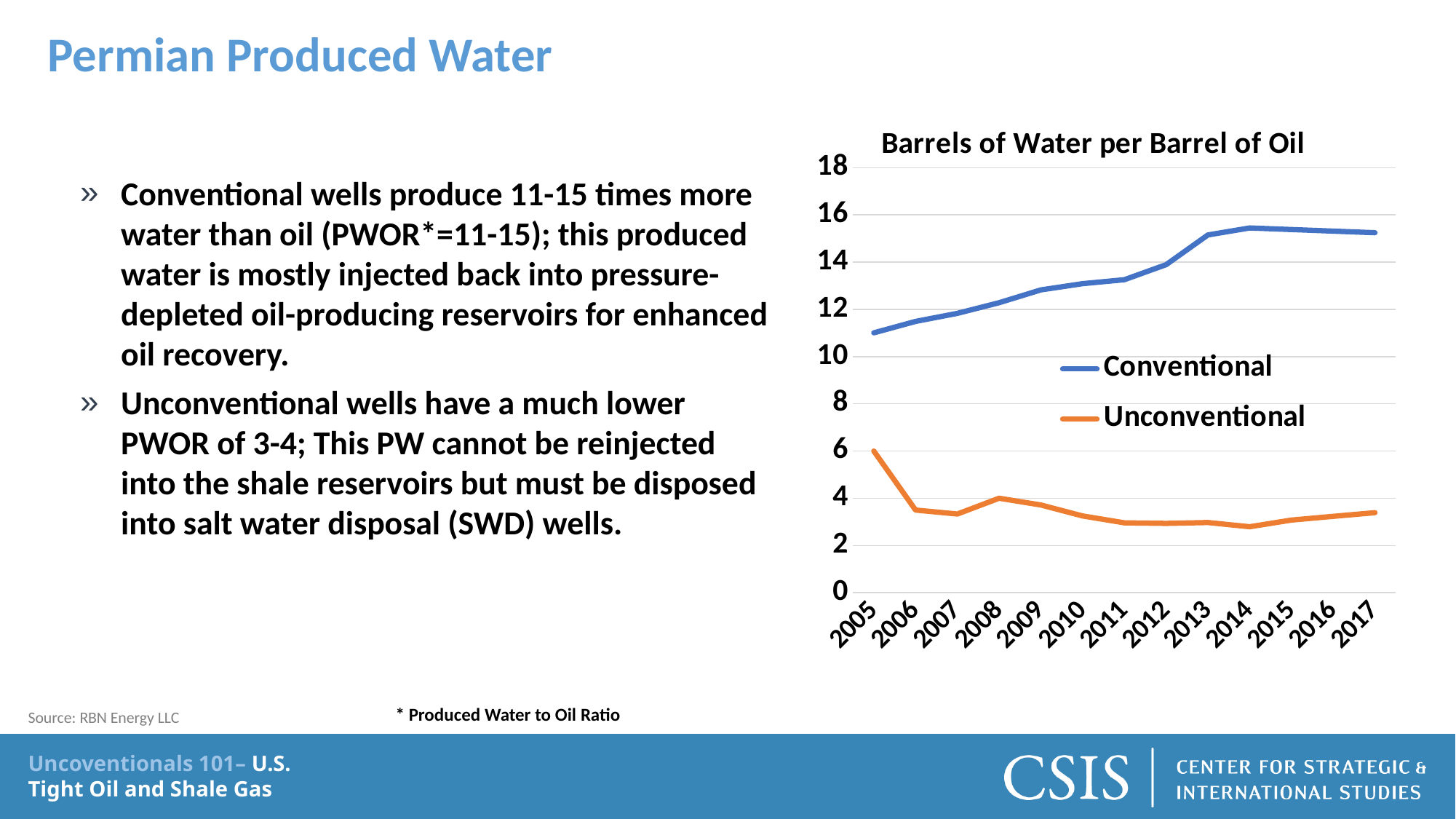
Is the Conventional value for 2017 greater or less than 14? greater Is the Conventional value for 2005 greater or less than 12? less In which year is the Unconventional series at its highest? 2005 How many series does the chart's legend list? 2 Is the Unconventional value for 2005 greater or less than 4? greater Does the Conventional series generally rise or fall from 2005 to 2017? Rise What is the title of the chart? Barrels of Water per Barrel of Oil How many years are shown on the x axis of the chart? 13 Which colour is used for the Unconventional line? Orange What type of chart is shown on the slide? Line chart In which year is the Conventional series at its lowest? 2005